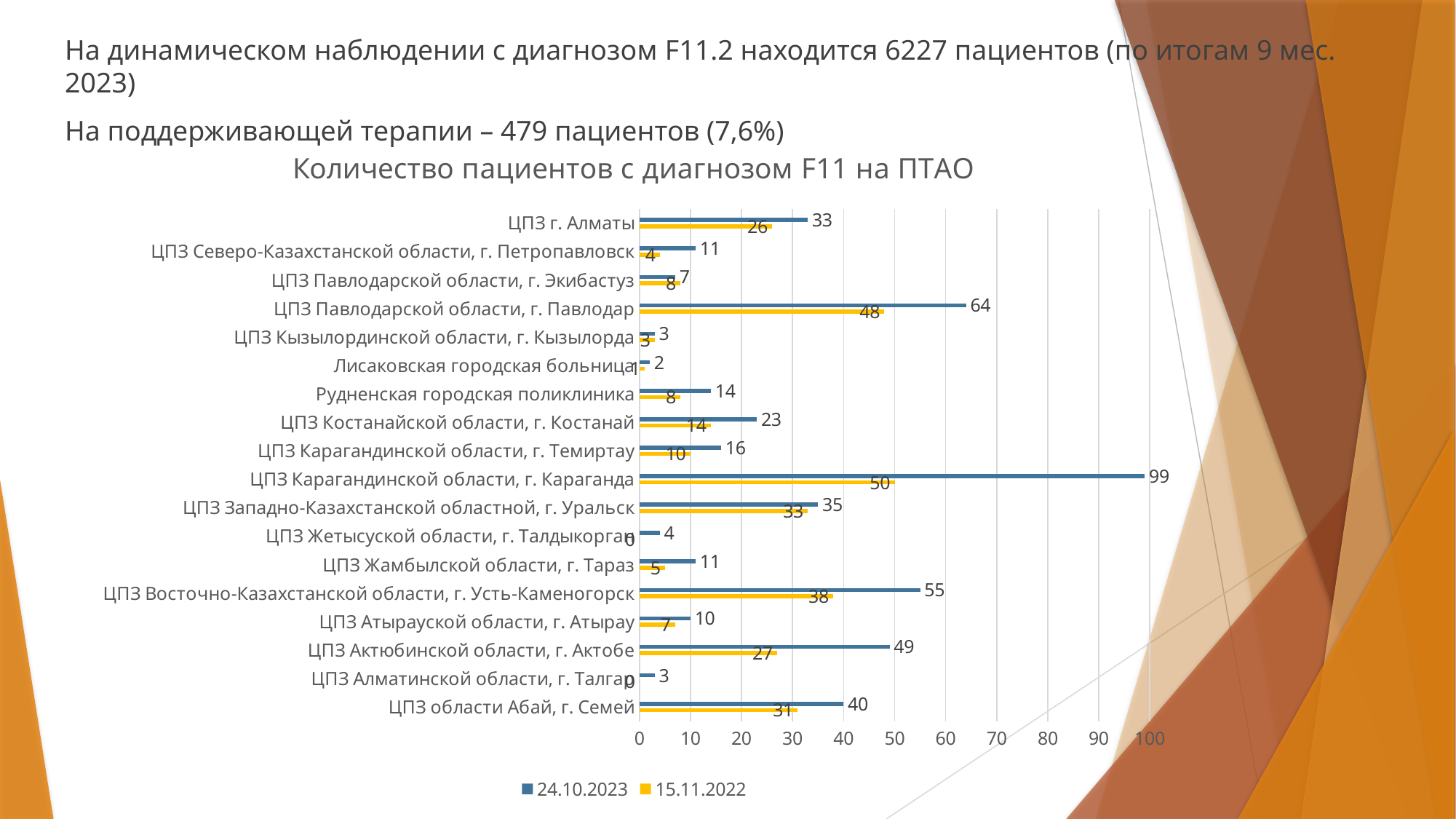
How many series does the legend list? 2 What is the difference between the 24.10.2023 and 15.11.2022 values for ЦПЗ Восточно-Казахстанской области, г. Усть-Каменогорск? 17 Which category has the lowest value in the 24.10.2023 series? Лисаковская городская больница What is the value for ЦПЗ Павлодарской области, г. Павлодар in the 15.11.2022 series? 48 How many categories (institutions) are shown on the chart? 18 What is the value for ЦПЗ Актюбинской области, г. Актобе in the 24.10.2023 series? 49 What is the title of the chart? Количество пациентов с диагнозом F11 на ПТАО Is the 24.10.2023 value for ЦПЗ Павлодарской области, г. Павлодар greater or less than 60? greater Which is larger for ЦПЗ Павлодарской области, г. Экибастуз: the 24.10.2023 value or the 15.11.2022 value? 15.11.2022 What type of chart is shown on the slide? bar chart What is the value for ЦПЗ Карагандинской области, г. Караганда in the 24.10.2023 series? 99 Which category has the highest value in the 24.10.2023 series? ЦПЗ Карагандинской области, г. Караганда